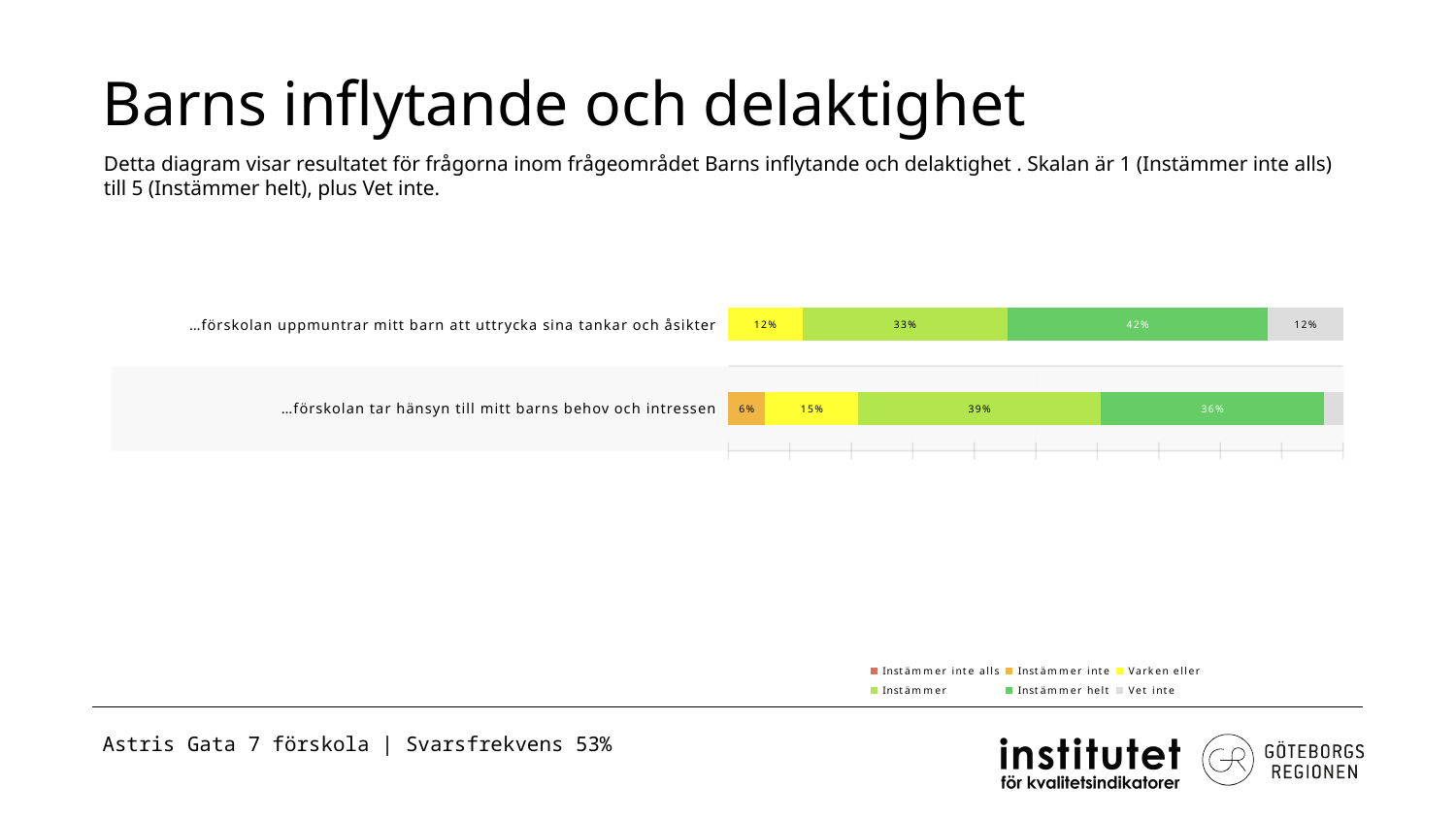
What is the 'Varken eller' value for '…förskolan tar hänsyn till mitt barns behov och intressen'? 15% What is the 'Instämmer helt' value for '…förskolan uppmuntrar mitt barn att uttrycka sina tankar och åsikter'? 42% What is the 'Instämmer' value for '…förskolan tar hänsyn till mitt barns behov och intressen'? 39% What is the difference between the 'Instämmer' values of the two questions (39% vs 33%)? 6% What kind of chart is shown on the slide? Stacked bar chart Which response category has the largest share for '…förskolan uppmuntrar mitt barn att uttrycka sina tankar och åsikter'? Instämmer helt How many series does the legend list? 6 How many question categories (bars) are plotted in the chart? 2 What is the 'Vet inte' value for '…förskolan uppmuntrar mitt barn att uttrycka sina tankar och åsikter'? 12% Which is larger: the 'Instämmer helt' share for '…förskolan uppmuntrar mitt barn att uttrycka sina tankar och åsikter' or for '…förskolan tar hänsyn till mitt barns behov och intressen'? …förskolan uppmuntrar mitt barn att uttrycka sina tankar och åsikter What is the 'Instämmer inte' value for '…förskolan tar hänsyn till mitt barns behov och intressen'? 6% What is the combined share of 'Instämmer' and 'Instämmer helt' for '…förskolan tar hänsyn till mitt barns behov och intressen'? 75%